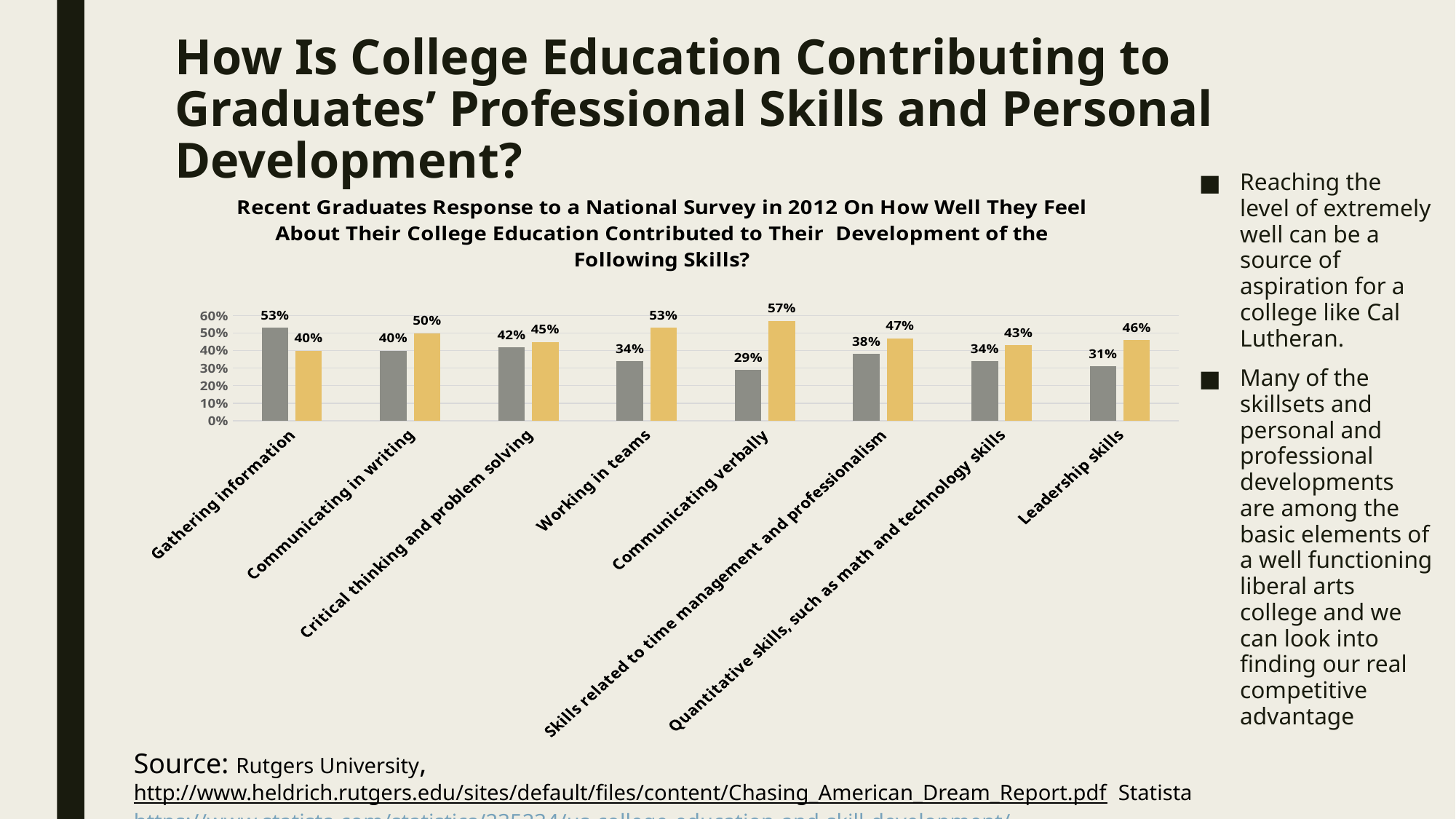
What is the value of the gold bar for Quantitative skills, such as math and technology skills? 43% How many skill categories are shown on the x axis of the chart? 8 Is the value of the gold bar for Working in teams greater or less than 50%? greater What is the value of the gray bar for Leadership skills? 31% What is the highest value shown on the chart's vertical axis? 60% What is the value of the gray bar for Gathering information? 53% What is the difference between the gray bar and the gold bar for Gathering information? 13 percentage points Which category has the highest gold bar? Communicating verbally What is the value of the gold bar for Communicating verbally? 57% What type of chart is shown on the slide? bar chart Which category has the lowest gray bar? Communicating verbally For Critical thinking and problem solving, which is larger, the gray bar or the gold bar? the gold bar